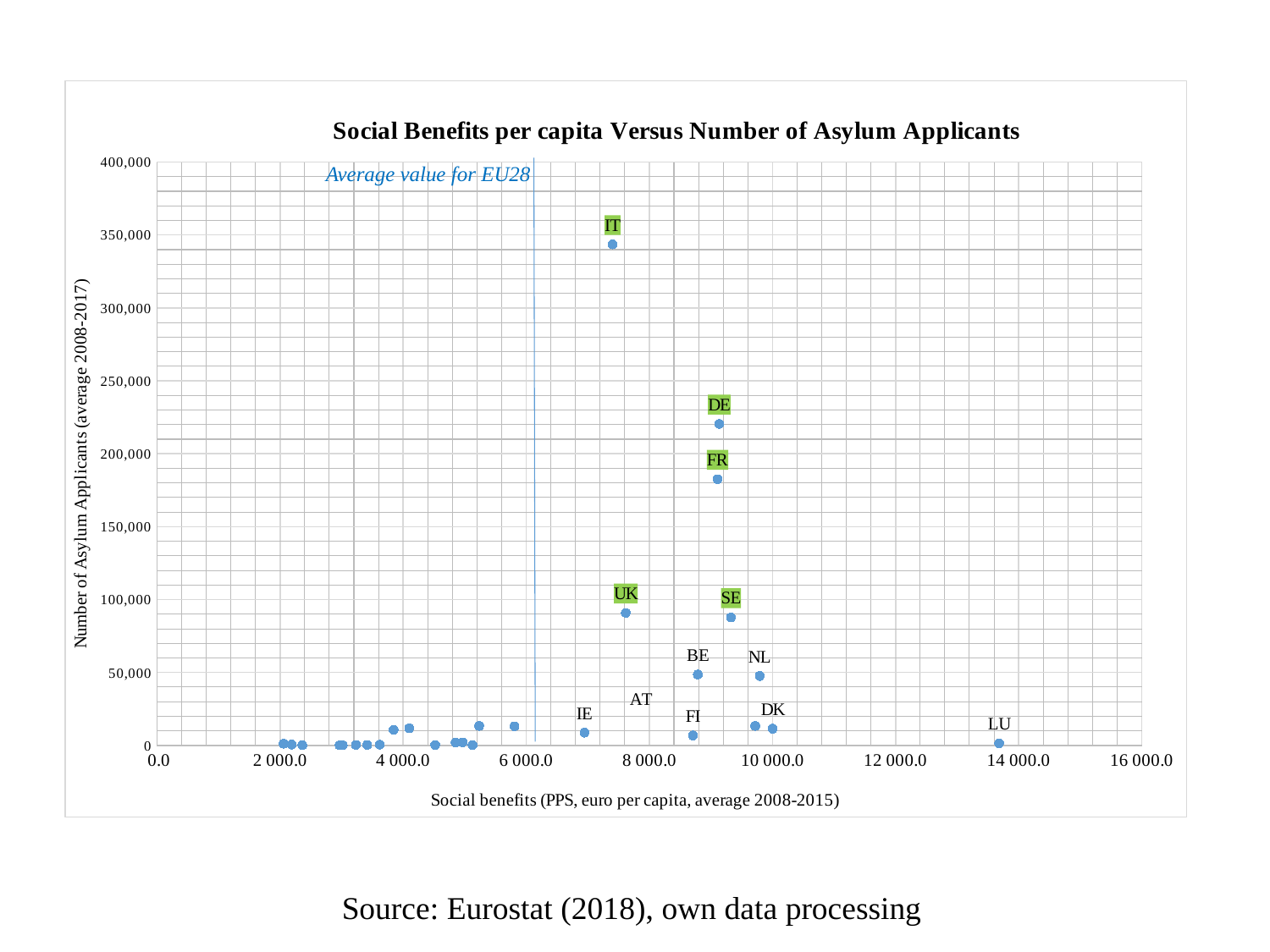
How many countries are labelled on the chart? 12 Is the number of asylum applicants for UK greater or less than 100,000? less Which labelled country has the highest number of asylum applicants? IT Is the number of asylum applicants for DE greater or less than 200,000? greater Is the social benefits value for LU greater or less than 12 000.0? greater Which has more asylum applicants, DE or FR? DE What does the vertical blue line in the chart represent, according to its label? Average value for EU28 What is the title of the chart? Social Benefits per capita Versus Number of Asylum Applicants What kind of chart is shown on the slide? scatter chart Which labelled country has the highest social benefits per capita? LU